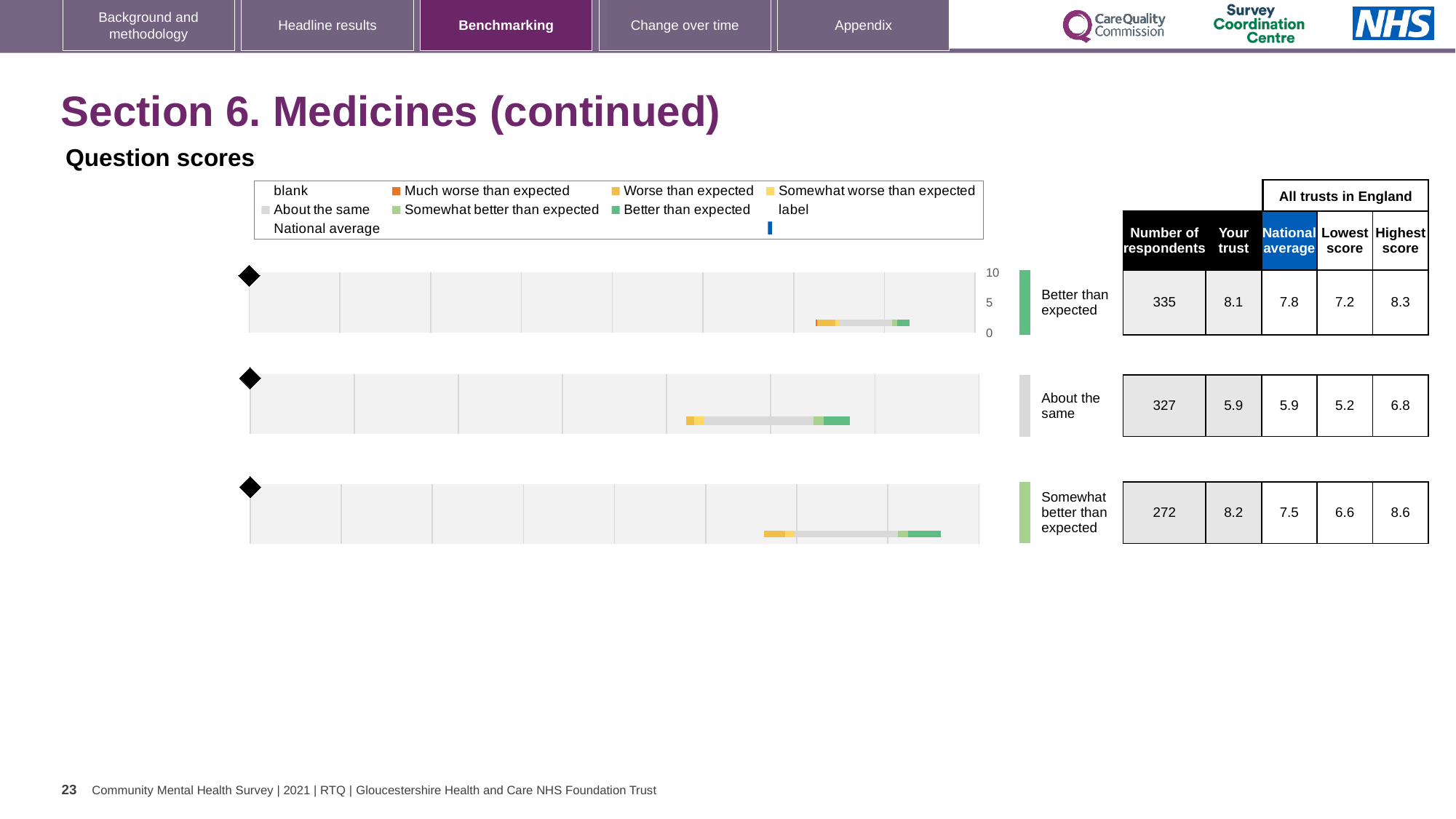
On the top chart (Better than expected), what is the national average score? 7.8 On the middle chart (About the same), is the 'Your trust' score greater or less than 5? greater On the top chart (Better than expected), which is larger: the 'Your trust' score or the national average? Your trust Which of the three charts has the lowest 'Your trust' score? About the same (middle chart) What is the maximum value shown on the score axis of the top chart? 10 What kind of chart is used to show the question scores on this slide? Bar chart On the bottom chart (Somewhat better than expected), what is the highest score across all trusts in England? 8.6 On the top chart (Better than expected), what is the 'Your trust' score? 8.1 On the middle chart (About the same), how many respondents are there? 327 Which of the three charts has the highest 'Your trust' score? Somewhat better than expected (bottom chart) How many question score charts are shown on the slide? 3 On the bottom chart (Somewhat better than expected), what is the difference between the 'Your trust' score and the national average? 0.7